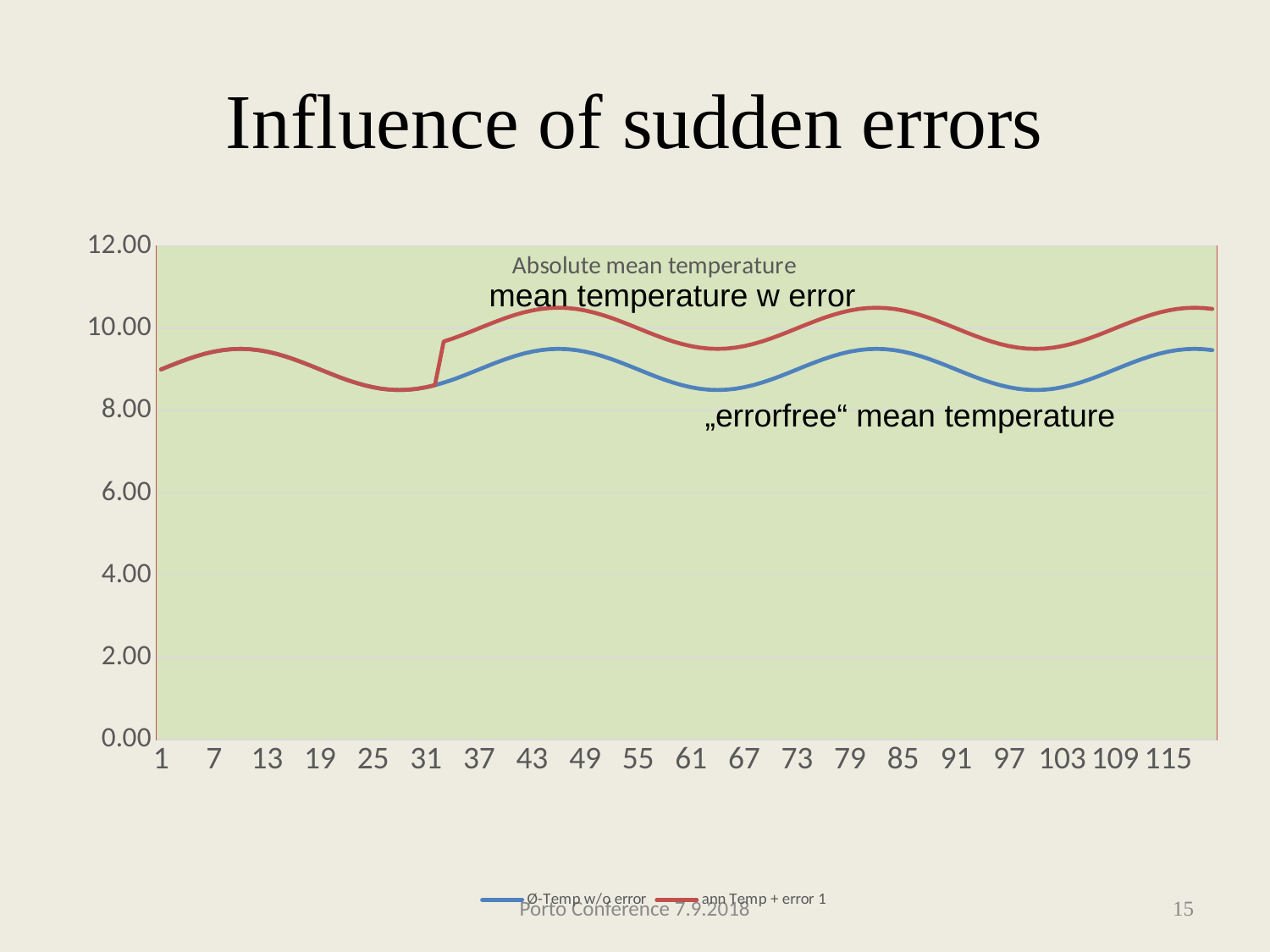
Around x = 33, does the red 'ann Temp + error 1' line jump up or down relative to the blue line? up Is the value of the blue 'Ø-Temp w/o error' line at x = 43 greater or less than 10.00? less What is the title printed inside the chart area? Absolute mean temperature Is the value of the red 'ann Temp + error 1' line at x = 1 greater or less than 10.00? less How many series does the chart legend list? 2 Is the value of the blue 'Ø-Temp w/o error' line at x = 61 greater or less than 8.00? greater What kind of chart is shown on the slide? line chart Which legend entry corresponds to the red line? ann Temp + error 1 At x = 85, which line is higher, the red 'ann Temp + error 1' line or the blue 'Ø-Temp w/o error' line? ann Temp + error 1